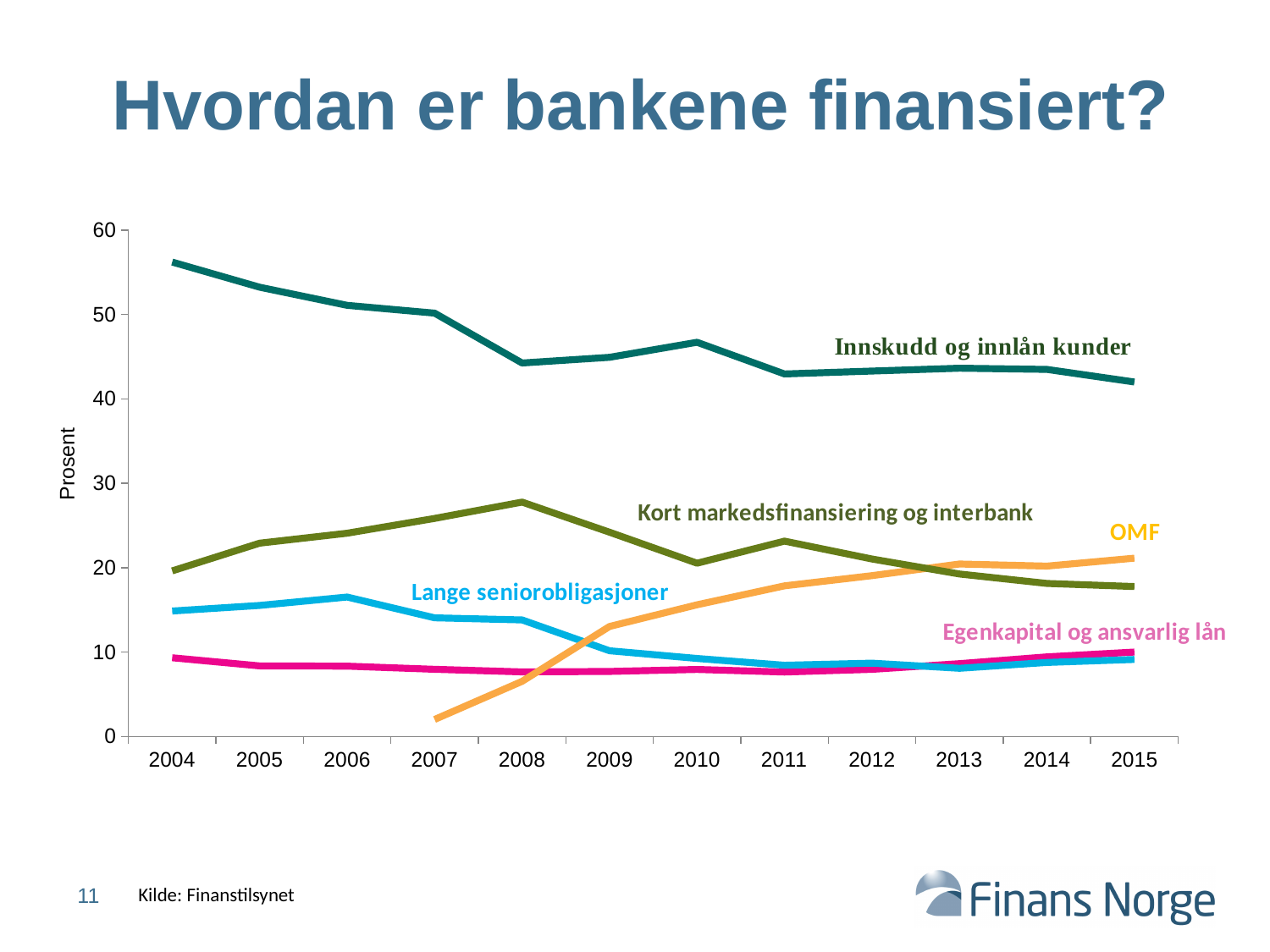
What kind of chart is shown on the slide? line chart What is the title of the chart on the slide? Hvordan er bankene finansiert? Is the value for Kort markedsfinansiering og interbank in 2008 greater or less than 30? less How many series (lines) are labelled on the chart? 5 Which series has the highest value in 2004? Innskudd og innlån kunder What is the label on the vertical axis of the chart? Prosent Does the Innskudd og innlån kunder line rise or fall from 2004 to 2015? fall How many years are shown along the x axis of the chart? 12 In 2015, which is larger: OMF or Kort markedsfinansiering og interbank? OMF Is the value for Innskudd og innlån kunder in 2004 greater or less than 50? greater Is the value for OMF in 2007 greater or less than 10? less Which series has the lowest value in 2007? OMF